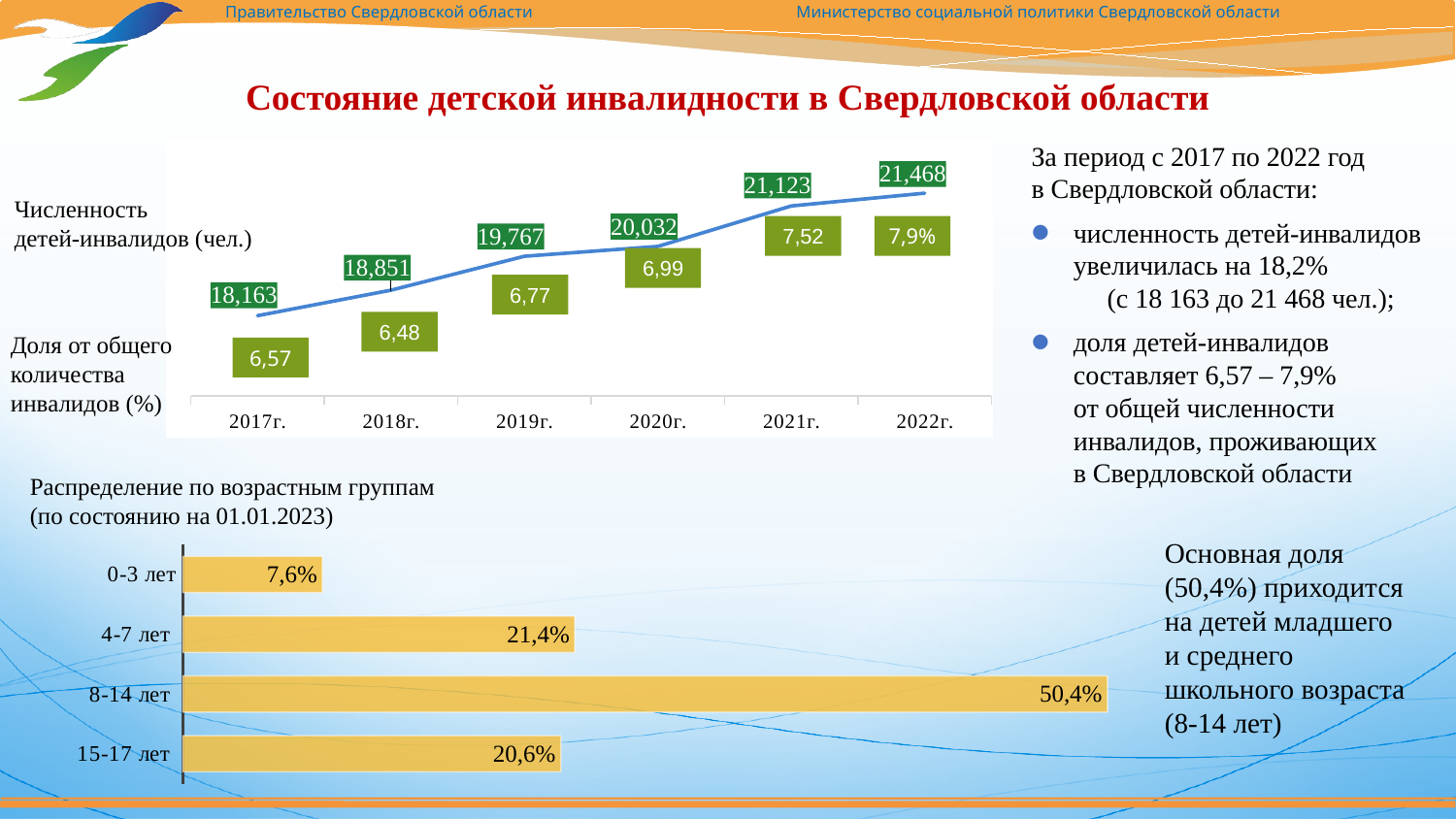
На верхней диаграмме растёт или падает численность детей-инвалидов с 2017г. по 2022г.? растёт На нижней диаграмме «Распределение по возрастным группам» какая возрастная группа имеет наименьшую долю? 0-3 лет На нижней диаграмме «Распределение по возрастным группам» какая доля больше: 4-7 лет или 15-17 лет? 4-7 лет На нижней диаграмме «Распределение по возрастным группам» какова доля группы 4-7 лет? 21,4% На верхней диаграмме какова доля от общего количества инвалидов (%) в 2018г.? 6,48 На верхней диаграмме в каком году численность детей-инвалидов наибольшая? 2022г. На нижней диаграмме «Распределение по возрастным группам» какая возрастная группа имеет наибольшую долю? 8-14 лет Сколько лет (категорий) показано на верхней диаграмме? 6 Какого типа нижняя диаграмма «Распределение по возрастным группам»? столбчатая (bar chart) На верхней диаграмме какова численность детей-инвалидов (чел.) в 2019г.? 19,767 На верхней диаграмме на сколько численность детей-инвалидов в 2022г. больше, чем в 2017г.? 3,305 На верхней диаграмме в каком году доля от общего количества инвалидов наименьшая? 2018г.